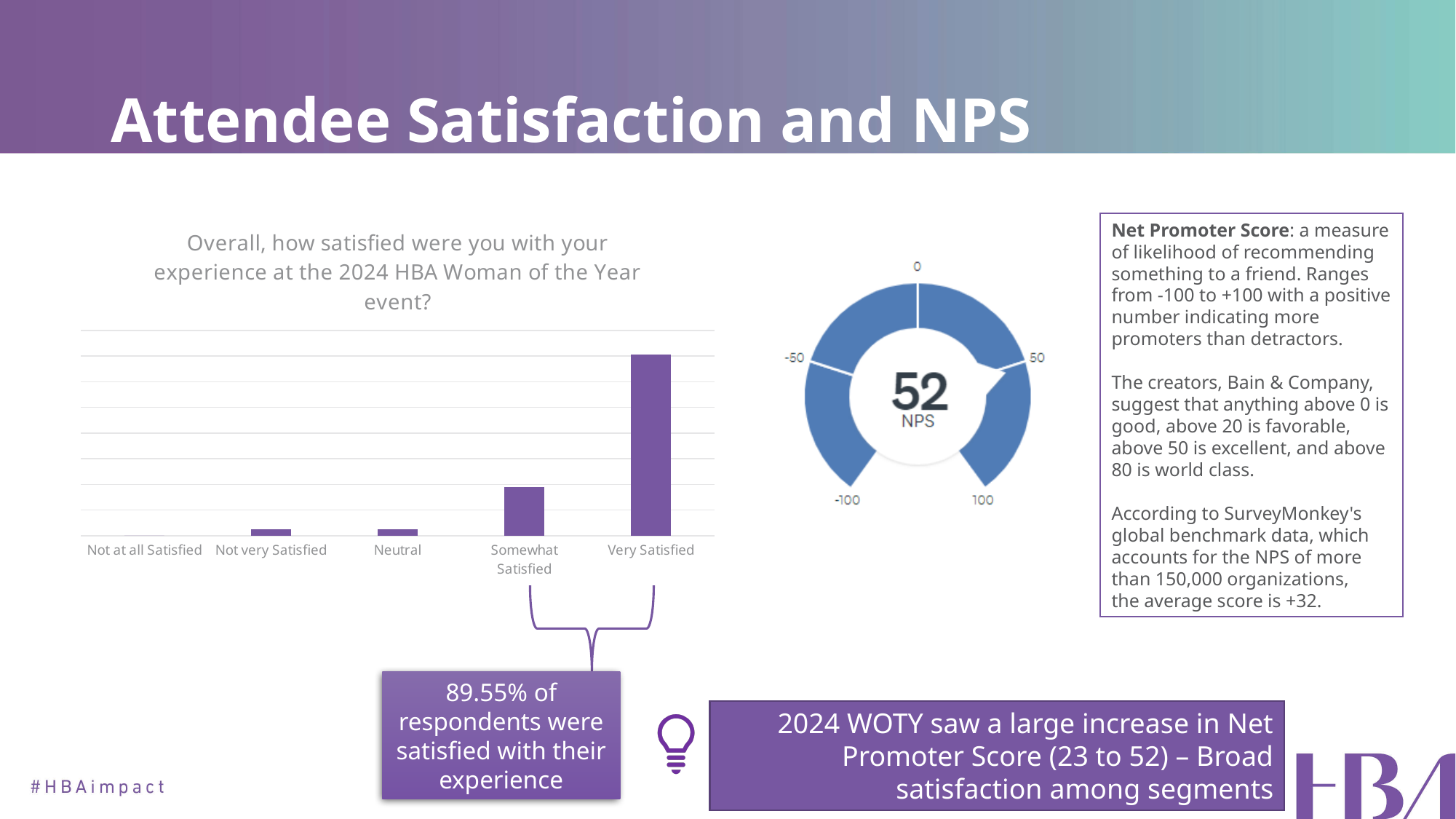
In the bar chart on the left, which is larger: Somewhat Satisfied or Very Satisfied? Very Satisfied In the bar chart on the left, which is larger: Neutral or Somewhat Satisfied? Somewhat Satisfied Is the NPS value shown on the gauge chart greater or less than 50? greater What kind of chart is the chart on the left of the slide? Bar chart In the bar chart on the left, do the values generally rise or fall from left to right along the x axis? Rise What kind of chart is the chart in the middle of the slide showing the NPS? Gauge chart What value does the gauge chart in the middle of the slide show? 52 What is the title of the bar chart on the left? Overall, how satisfied were you with your experience at the 2024 HBA Woman of the Year event? In the bar chart on the left, which category has the lowest value? Not at all Satisfied What are the minimum and maximum values marked on the NPS gauge chart? -100 and 100 In the bar chart on the left, which category has the highest value? Very Satisfied How many categories are shown on the x axis of the bar chart on the left? 5